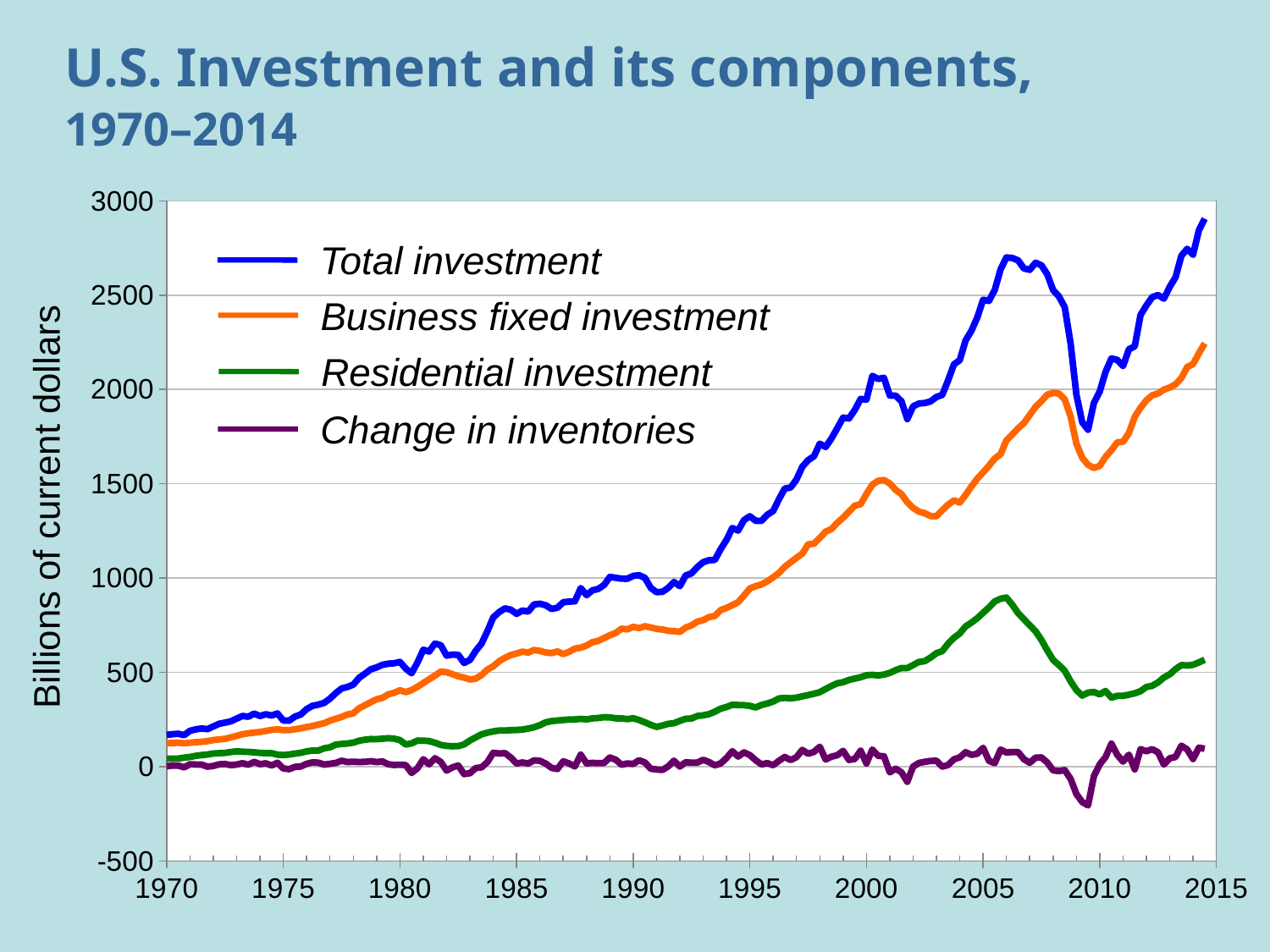
Is the value for Total investment in 1990 greater or less than 500? greater What kind of chart is shown on the slide? line chart Is the value for Business fixed investment in 2000 greater or less than 1000? greater Is the value for Change in inventories in 2009 greater or less than 0? less In 2005, which is larger, Business fixed investment or Residential investment? Business fixed investment How many series does the legend list? 4 What colour is the Total investment line? blue Does Total investment overall rise or fall from 1970 to 2014? rise Which series has the highest values across the whole period? Total investment What is the label on the vertical axis? Billions of current dollars